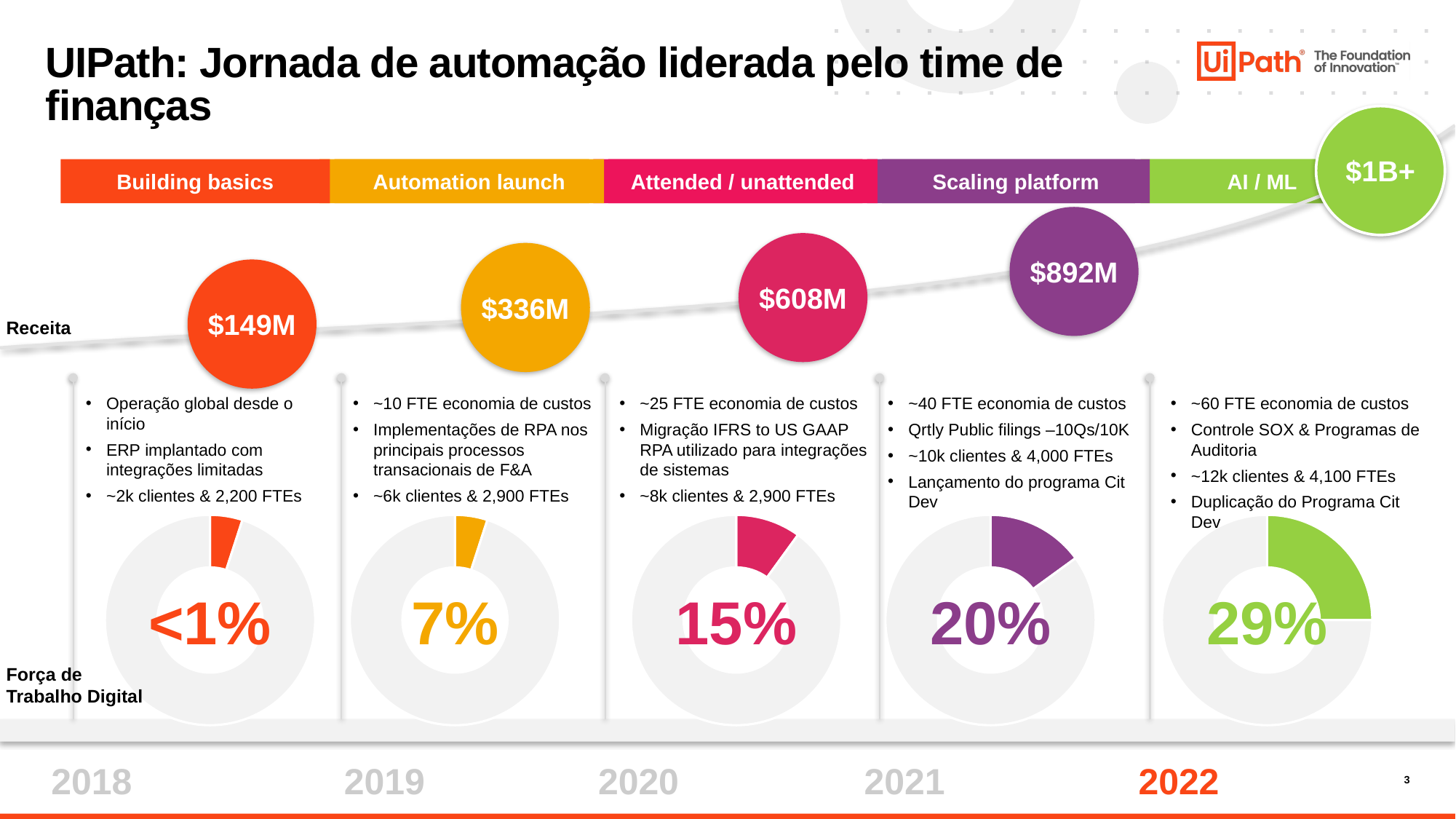
What is the difference in Receita between 2019 and 2018? $187M Which year has the highest Receita value? 2022 What is the Receita value shown for 2021? $892M What is the difference in Força de Trabalho Digital percentage between 2022 and 2021? 9% What is the Receita value shown for 2022? $1B+ What is the Força de Trabalho Digital percentage shown for 2022? 29% What is the Receita (revenue) value shown for 2018? $149M Do the Receita values rise or fall from 2018 to 2022? rise What is the Força de Trabalho Digital percentage shown for 2019? 7% What is the Receita value shown for 2020? $608M How many years are shown along the timeline? 5 Which year has the lowest Força de Trabalho Digital percentage? 2018